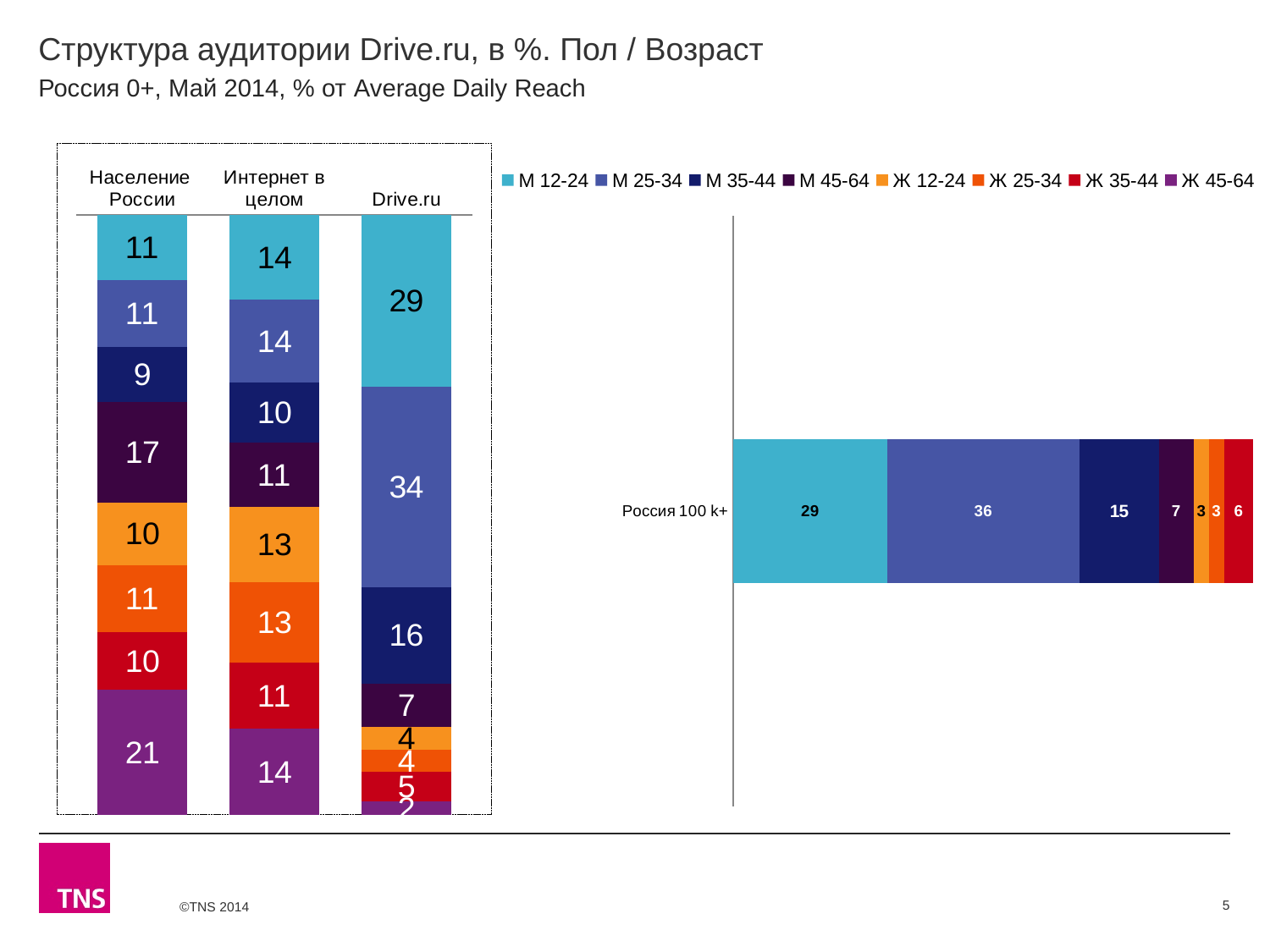
In the right chart (Россия 100 k+), what is the value of the М 45-64 segment? 7 In the right chart (Россия 100 k+), what is the value of the М 25-34 segment? 36 In the left chart, which has the larger М 35-44 value: Drive.ru or Интернет в целом? Drive.ru In the left chart, what is the value of the Ж 45-64 segment for Население России? 21 In the right chart (Россия 100 k+), what is the value of the М 35-44 segment? 15 In the left chart, what is the value of the М 12-24 segment for Интернет в целом? 14 How many series does the legend list? 8 What kind of chart is the left chart? Stacked bar chart In the left chart, what is the value of the М 25-34 segment for Drive.ru? 34 In the left chart, what is the difference between the М 25-34 value for Drive.ru and the М 25-34 value for Население России? 23 How many columns (categories) are shown in the left chart? 3 In the left chart, which column has the largest М 12-24 segment? Drive.ru